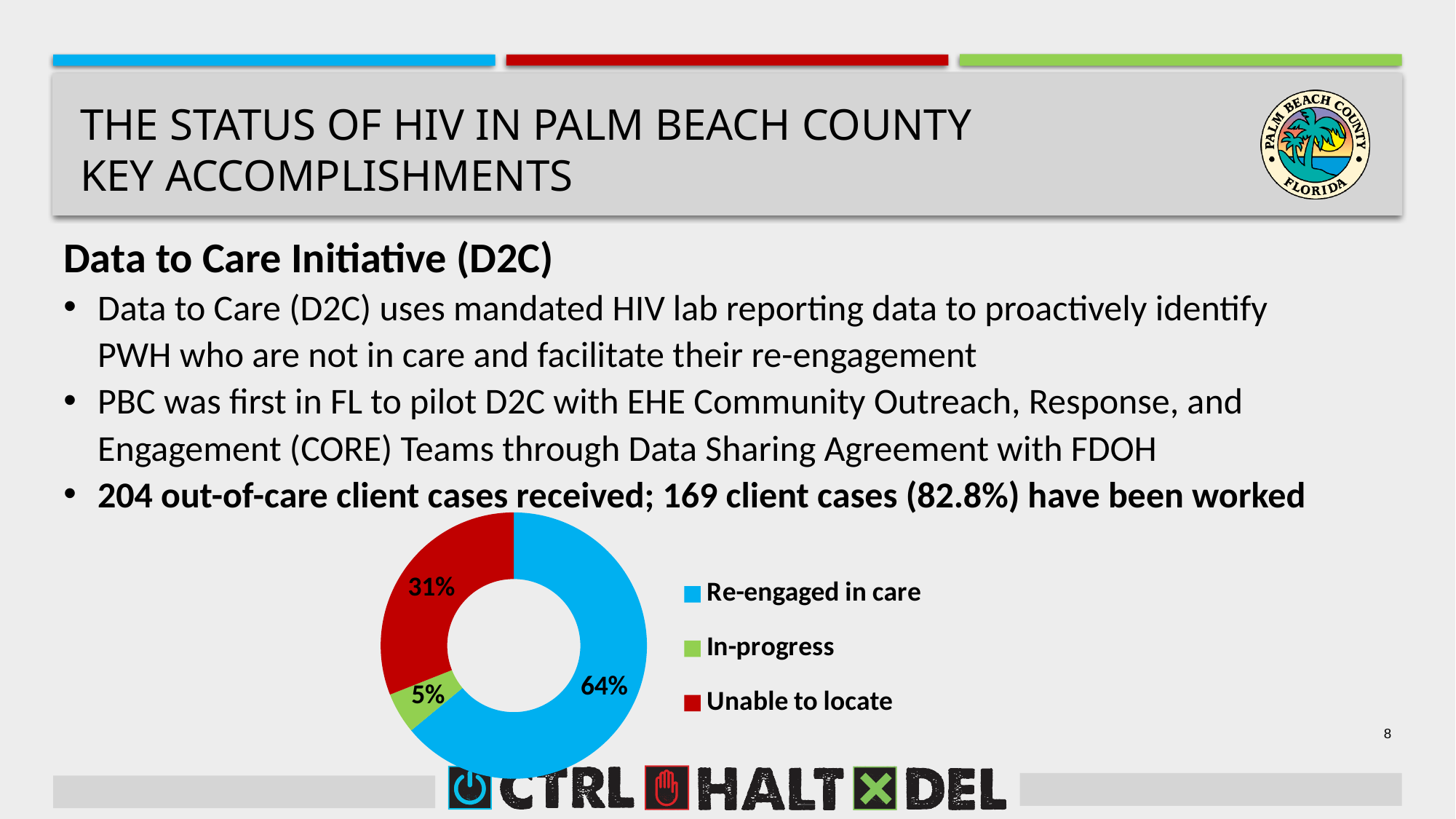
What is the difference in percentage points between Re-engaged in care and Unable to locate? 33 How many categories does the donut chart show? 3 Which category has the largest share of the donut chart? Re-engaged in care What percentage of the donut chart is labelled Unable to locate? 31% What colour represents Unable to locate in the chart? Red What percentage of the donut chart is labelled In-progress? 5% Which category has the smallest share of the donut chart? In-progress What colour represents In-progress in the chart? Green What is the combined share of Re-engaged in care and In-progress? 69% What percentage of the donut chart is labelled Re-engaged in care? 64% Which is larger in the donut chart, Unable to locate or In-progress? Unable to locate What kind of chart is shown on the slide? Donut (pie) chart